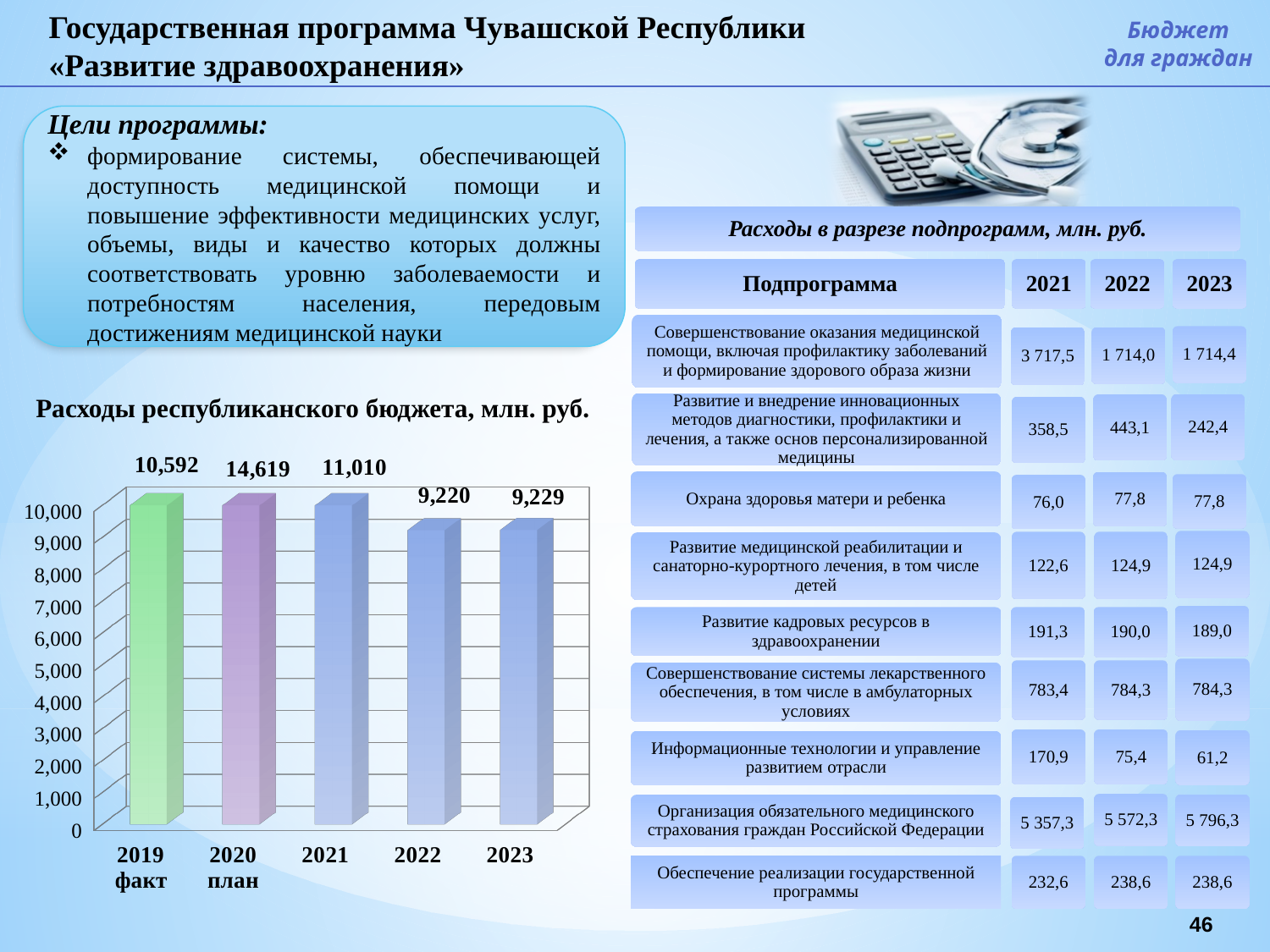
What is the value for 2021 in the chart 'Расходы республиканского бюджета, млн. руб.'? 11,010 Which category has the lowest value in the chart 'Расходы республиканского бюджета, млн. руб.'? 2022 In the chart 'Расходы республиканского бюджета, млн. руб.', what is the difference between the values for 2019 факт and 2022? 1,372 What kind of chart is 'Расходы республиканского бюджета, млн. руб.'? bar chart In the chart 'Расходы республиканского бюджета, млн. руб.', which is larger: the value for 2019 факт or the value for 2021? 2021 What is the value for 2020 план in the chart 'Расходы республиканского бюджета, млн. руб.'? 14,619 What is the value for 2023 in the chart 'Расходы республиканского бюджета, млн. руб.'? 9,229 Which category has the highest value in the chart 'Расходы республиканского бюджета, млн. руб.'? 2020 план How many categories are shown in the chart 'Расходы республиканского бюджета, млн. руб.'? 5 In the chart 'Расходы республиканского бюджета, млн. руб.', is the value for 2022 greater or less than 10,000? less What is the value for 2019 факт in the chart 'Расходы республиканского бюджета, млн. руб.'? 10,592 In the chart 'Расходы республиканского бюджета, млн. руб.', what is the difference between the values for 2020 план and 2021? 3,609